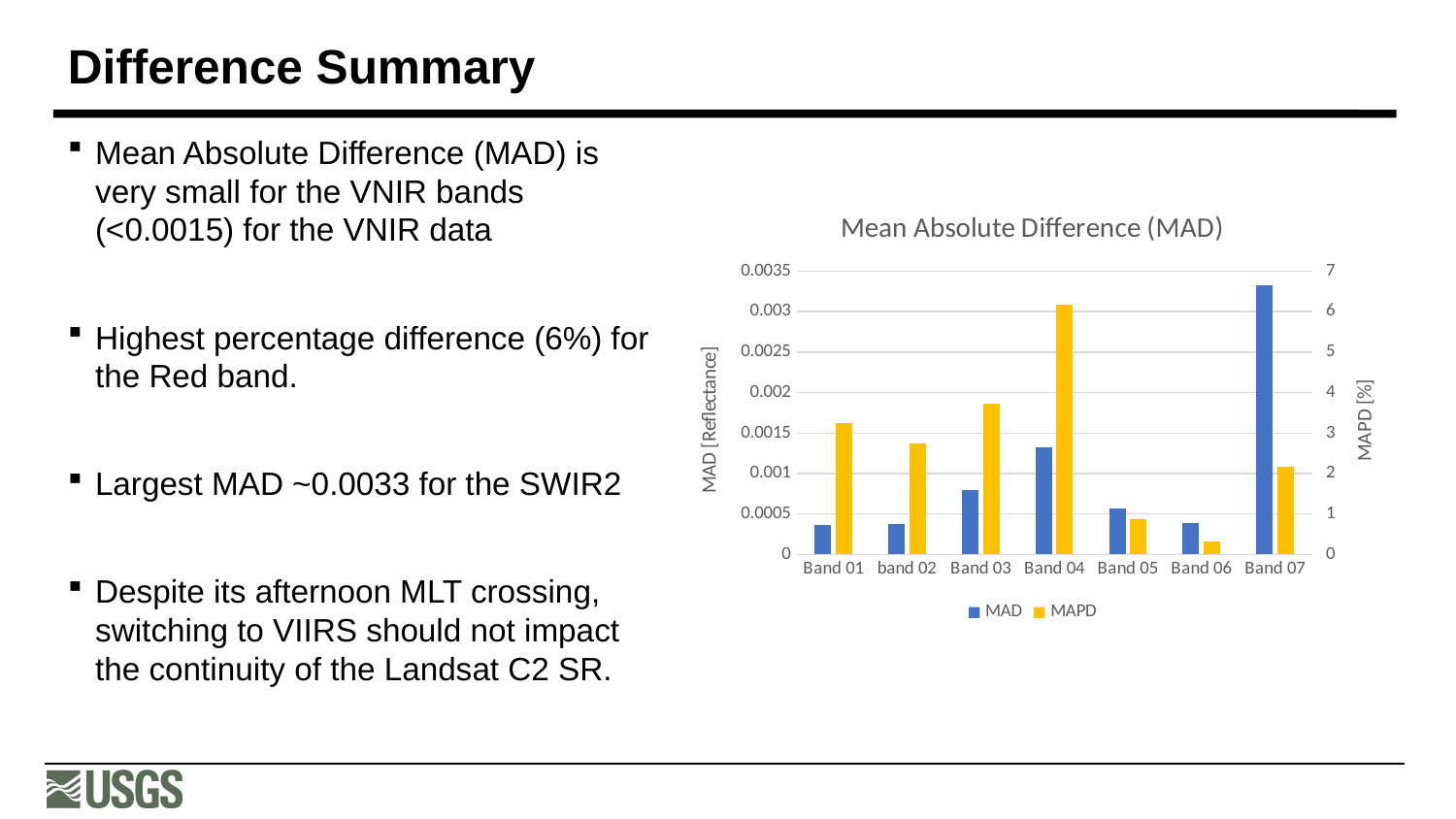
What kind of chart is shown on the slide? bar chart Which has the larger MAPD value, band 02 or Band 03? Band 03 Which band has the lowest MAPD value? Band 06 Is the MAPD value for Band 06 greater or less than 1? less How many series does the chart legend list? 2 Which has the larger MAD value, Band 03 or Band 04? Band 04 Is the MAPD value for Band 04 greater or less than 6? greater Which band has the highest MAPD value? Band 04 How many bands (categories) are shown on the x axis of the chart? 7 Which band has the highest MAD value? Band 07 Is the MAD value for Band 07 greater or less than 0.003? greater What is the title of the chart? Mean Absolute Difference (MAD)